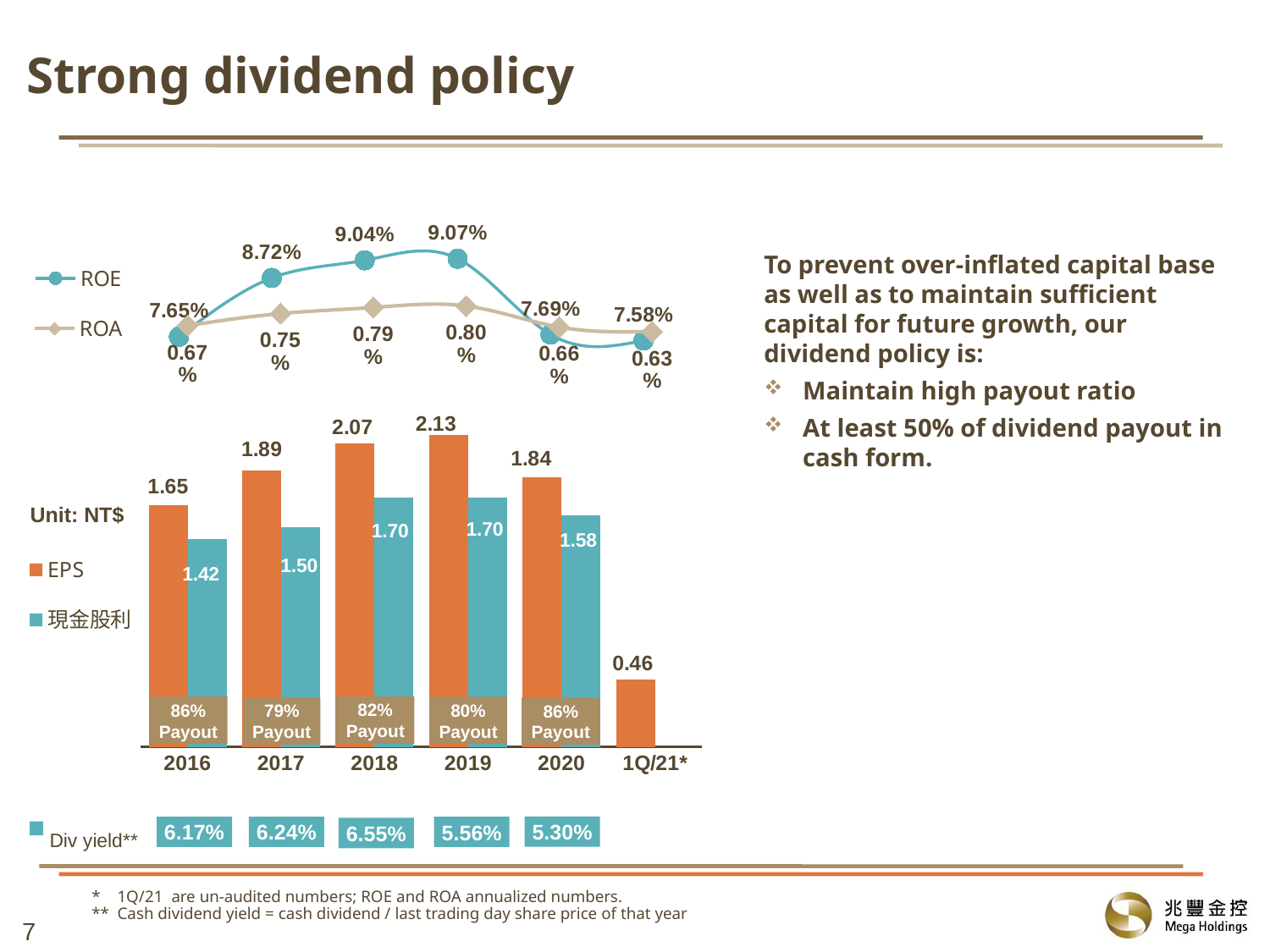
What type of chart shows the EPS and cash dividend data? Bar chart In the ROE/ROA line chart, what is the difference between the ROE in 2018 and the ROE in 2016? 1.39% In the ROE/ROA line chart, how many series does the legend list? 2 In the EPS and cash dividend bar chart, what is the difference between EPS and cash dividend in 2017? 0.39 In the EPS and cash dividend bar chart, which year had the highest EPS? 2019 In the EPS and cash dividend bar chart, how many categories are shown on the x axis? 6 In the ROE/ROA line chart, what was the ROA in 2017? 0.75% In the EPS and cash dividend bar chart, what was the EPS in 2018? 2.07 In the ROE/ROA line chart, which year had the lowest ROA? 1Q/21* In the ROE/ROA line chart, what was the ROE in 2019? 9.07% In the EPS and cash dividend bar chart, what was the cash dividend (現金股利) in 2020? 1.58 In the EPS and cash dividend bar chart, what was the payout ratio shown for 2017? 79%